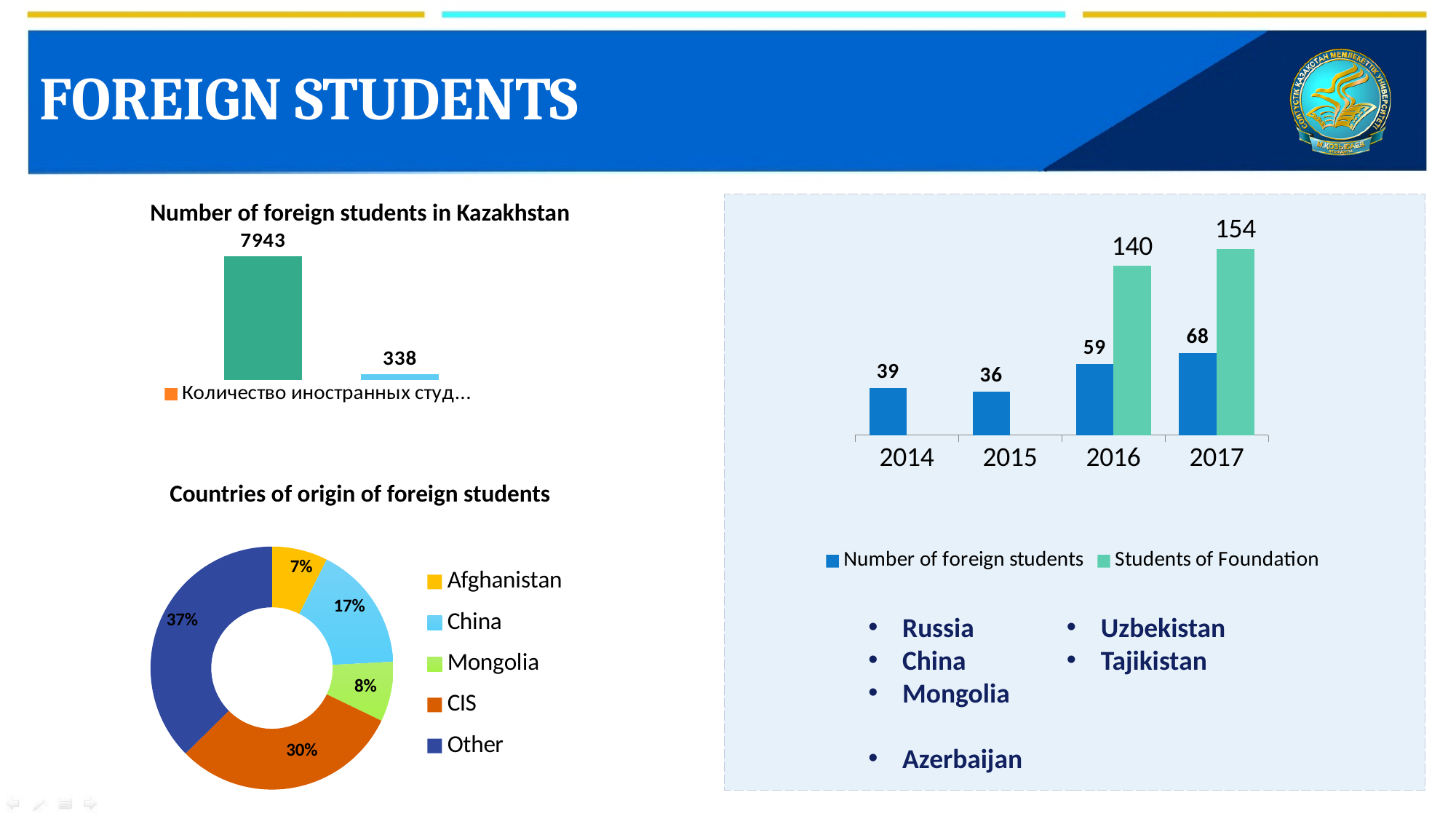
In the 'Countries of origin of foreign students' chart, which category has the largest share? Other In the 'Countries of origin of foreign students' chart, what share is China? 17% In the chart on the right, what is the difference between Students of Foundation in 2017 and in 2016? 14 What kind of chart is 'Countries of origin of foreign students'? doughnut (pie) chart In the chart on the right, how many series does the legend list? 2 In the 'Number of foreign students in Kazakhstan' chart, what is the value of the taller bar? 7943 In the chart on the right, does the number of foreign students rise or fall from 2015 to 2017? rise In the chart on the right, which year has the lowest number of foreign students? 2015 In the chart on the right, what is the value for Students of Foundation in 2016? 140 In the 'Countries of origin of foreign students' chart, which is larger, CIS or Mongolia? CIS In the chart on the right, what is the number of foreign students in 2017? 68 In the chart on the right, how many years are shown on the x axis? 4